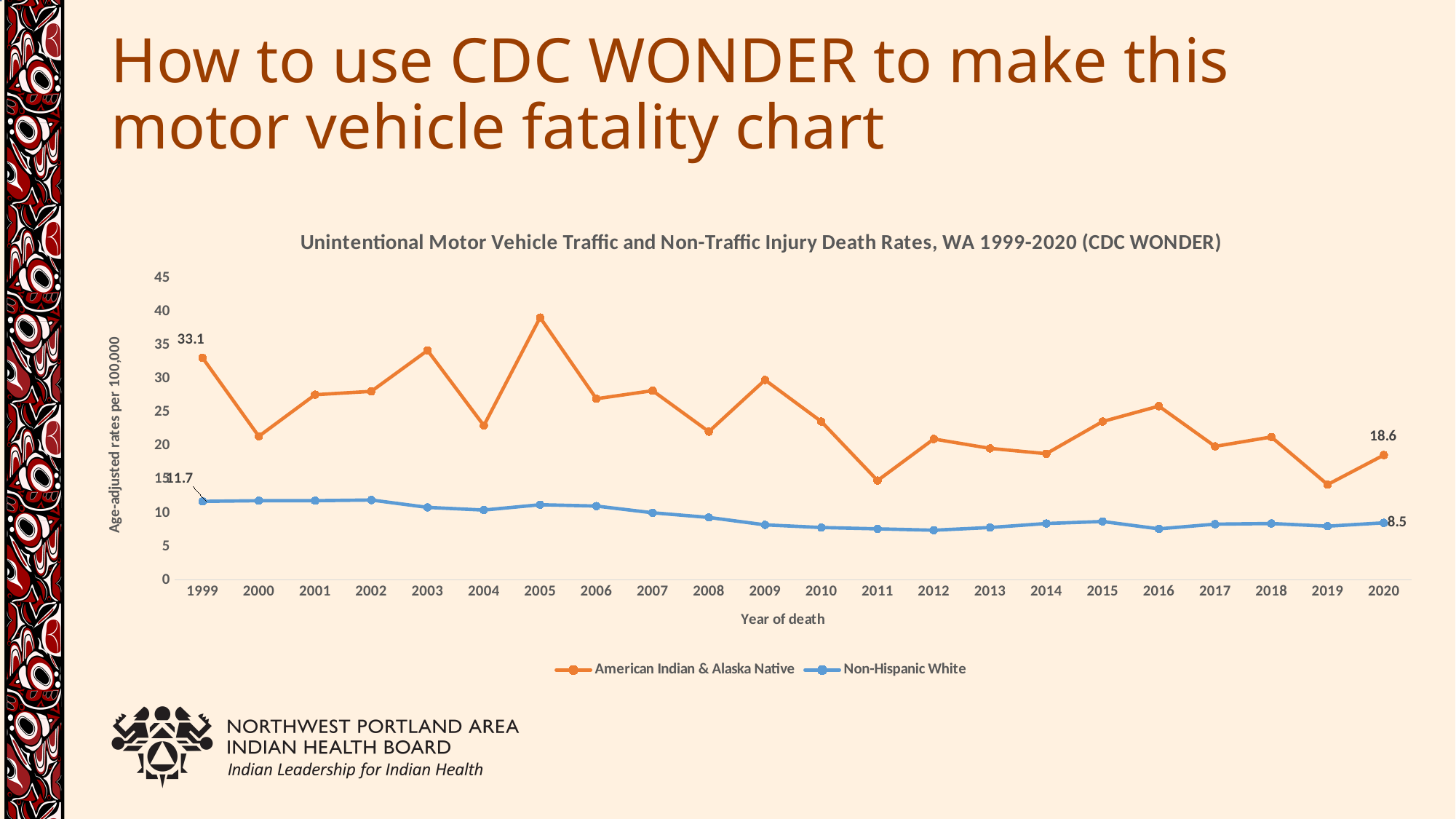
What is the age-adjusted death rate for American Indian & Alaska Native in 1999? 33.1 What is the label of the y axis? Age-adjusted rates per 100,000 What type of chart is shown on the slide? Line chart What is the difference between the American Indian & Alaska Native rate and the Non-Hispanic White rate in 2020? 10.1 What is the age-adjusted death rate for Non-Hispanic White in 1999? 11.7 How many years are plotted along the x axis? 22 In which year does the American Indian & Alaska Native series reach its highest value? 2005 Which series has the higher value in 2011, American Indian & Alaska Native or Non-Hispanic White? American Indian & Alaska Native What is the age-adjusted death rate for American Indian & Alaska Native in 2020? 18.6 Is the American Indian & Alaska Native value for 2005 greater or less than 35? greater What is the age-adjusted death rate for Non-Hispanic White in 2020? 8.5 How many series does the legend list? 2